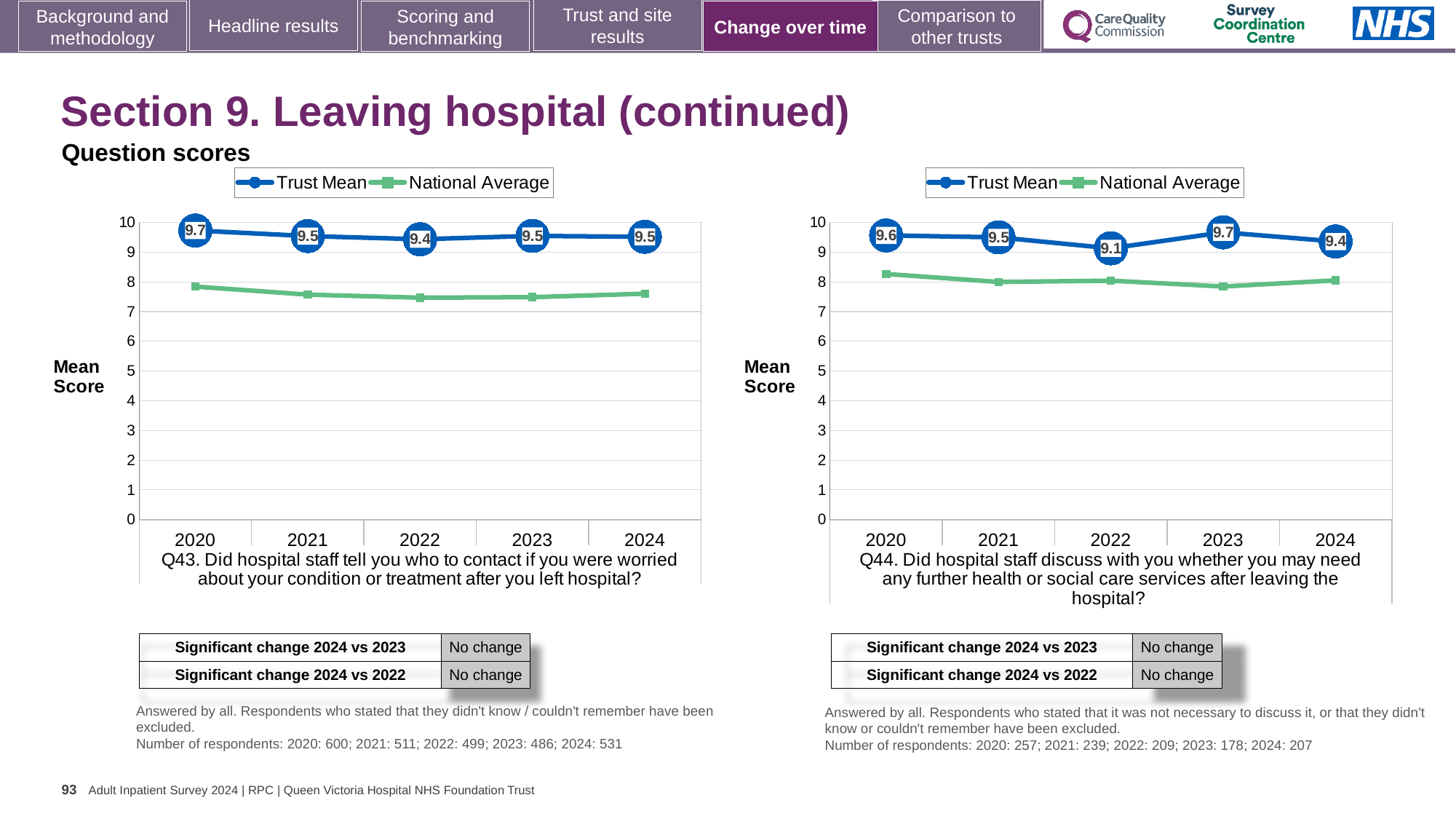
In the Q44 chart (right), what is the Trust Mean score for 2022? 9.1 In the Q43 chart (left), which is larger in 2024: the Trust Mean or the National Average? Trust Mean In the Q43 chart (left), what is the Trust Mean score for 2020? 9.7 In the Q44 chart (right), is the National Average for 2020 greater or less than 8? greater In the Q44 chart (right), which year has the highest Trust Mean score? 2023 In the Q43 chart (left), what is the difference between the Trust Mean scores for 2020 and 2022? 0.3 In the Q44 chart (right), what is the difference between the Trust Mean scores for 2023 and 2022? 0.6 In the Q43 chart (left), is the National Average for 2022 greater or less than 8? less In the Q44 chart (right), which year has the lowest Trust Mean score? 2022 How many years are shown on the x axis of the Q43 chart (left)? 5 How many series does the legend of the Q44 chart (right) list? 2 What kind of chart is the Q43 chart (left)? Line chart